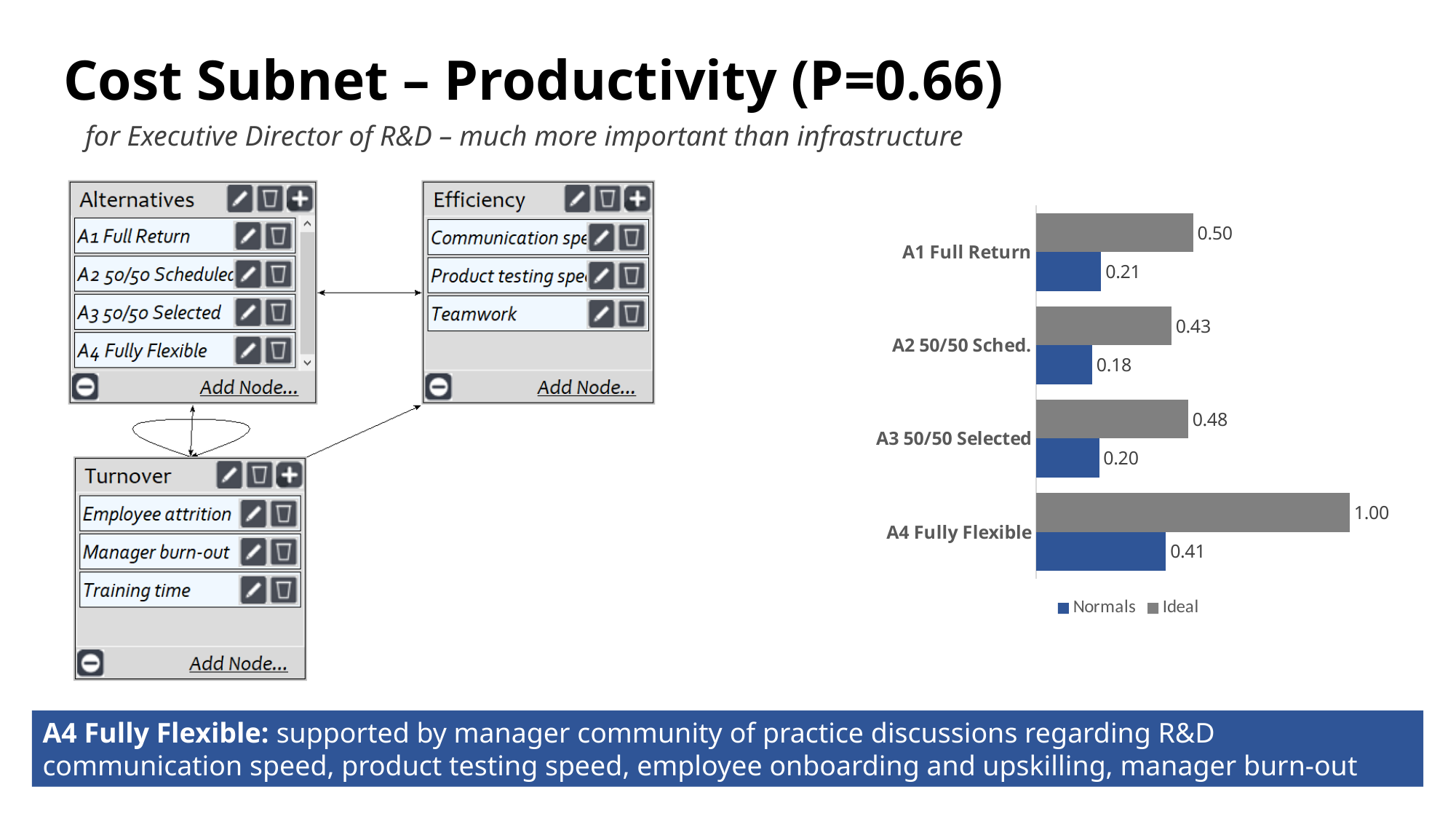
How many alternatives are shown on the chart? 4 What is the Ideal value for A2 50/50 Sched.? 0.43 How many series does the chart legend list? 2 What is the Normals value for A3 50/50 Selected? 0.20 What is the Ideal value for A4 Fully Flexible? 1.00 Which alternative has the lowest Normals value? A2 50/50 Sched. What is the difference between the Ideal values for A4 Fully Flexible and A1 Full Return? 0.50 Which series is shown in blue in the chart? Normals What kind of chart is shown on the slide? Bar chart What is the Normals value for A1 Full Return? 0.21 Which alternative has the highest Ideal value? A4 Fully Flexible Which is larger, the Normals value for A4 Fully Flexible or the Normals value for A1 Full Return? A4 Fully Flexible